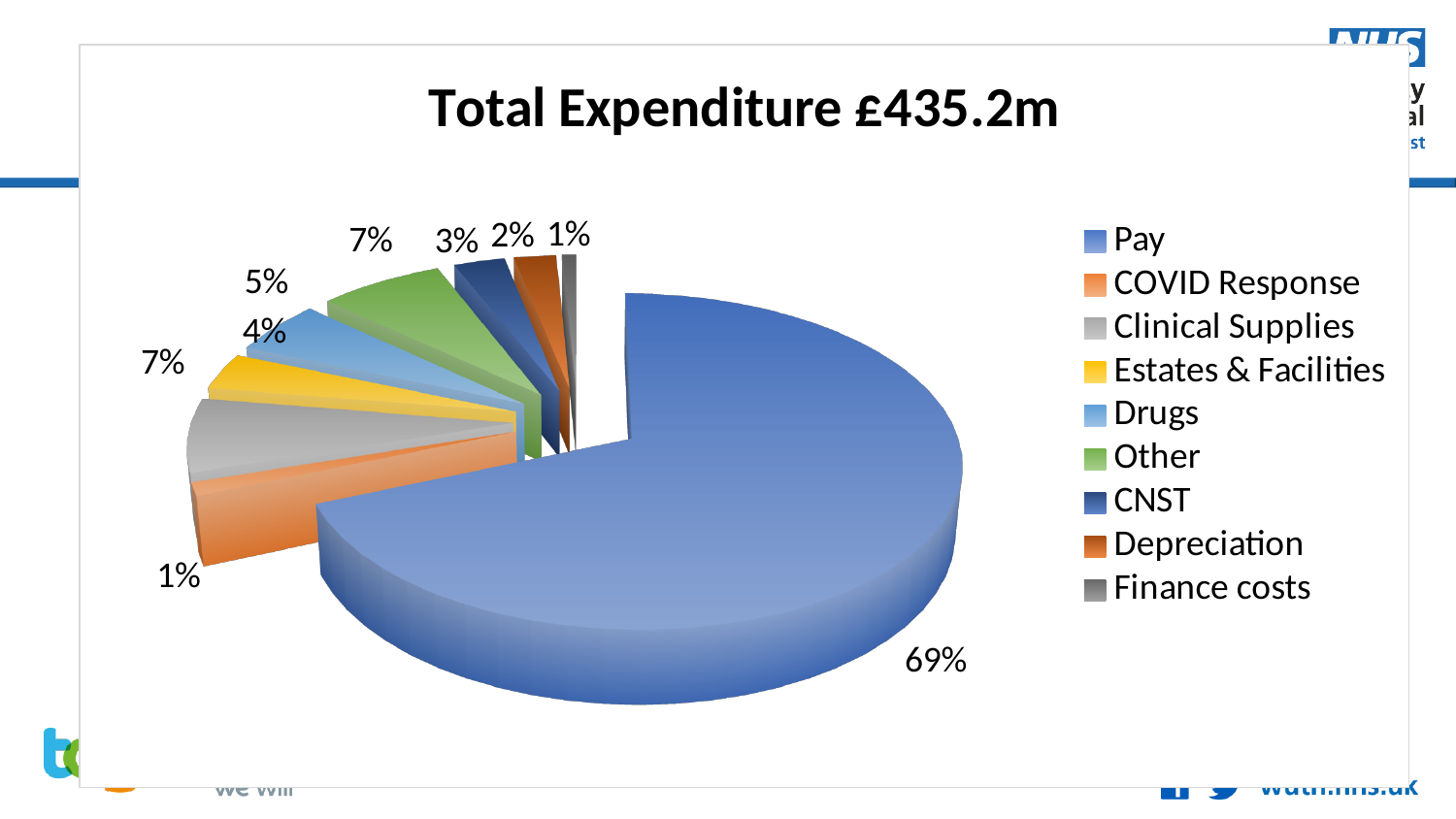
What is the difference in percentage points between the Pay share and the Other share? 62 What share of total expenditure is Depreciation? 2% What share of total expenditure is Other? 7% How many categories does the legend list? 9 What share of total expenditure is Pay? 69% What is the title of the chart? Total Expenditure £435.2m Which category has the largest share of total expenditure? Pay Which is larger, the share for Drugs or the share for Estates & Facilities? Drugs How many slices does the pie chart have? 9 What kind of chart is shown on the slide? pie chart